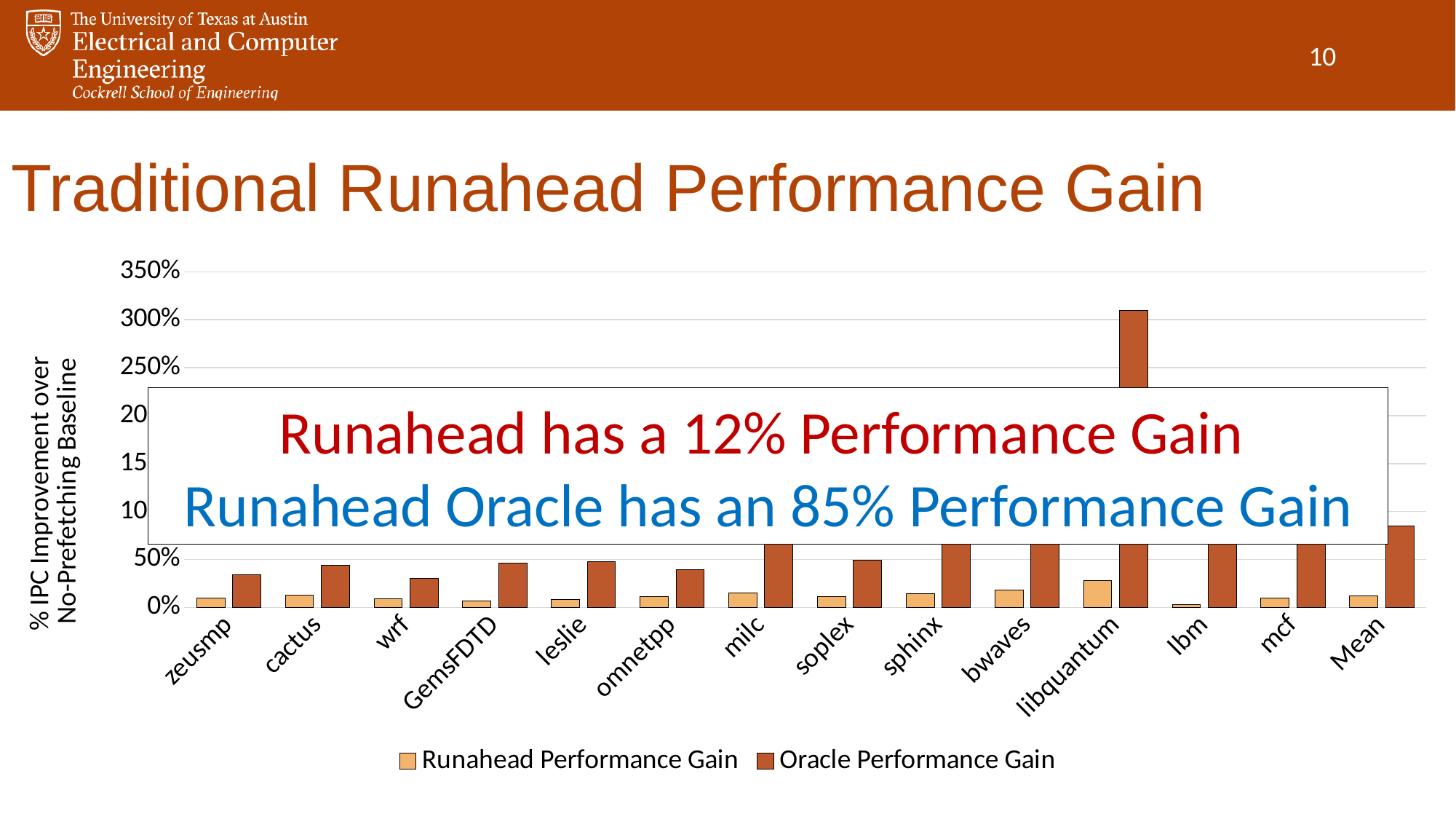
How many categories are shown along the x axis? 14 What is the title of the slide containing the chart? Traditional Runahead Performance Gain For mcf, which is larger: the Runahead Performance Gain or the Oracle Performance Gain? Oracle Performance Gain Is the Oracle Performance Gain for wrf greater or less than 50%? less Is the Runahead Performance Gain for libquantum greater or less than 50%? less Is the Oracle Performance Gain for libquantum greater or less than 300%? greater Which category has the highest Runahead Performance Gain? libquantum What is the label on the y axis of the chart? % IPC Improvement over No-Prefetching Baseline Which category has the lowest Runahead Performance Gain? lbm How many series does the legend list? 2 Which category has the highest Oracle Performance Gain? libquantum What kind of chart is shown on the slide? bar chart